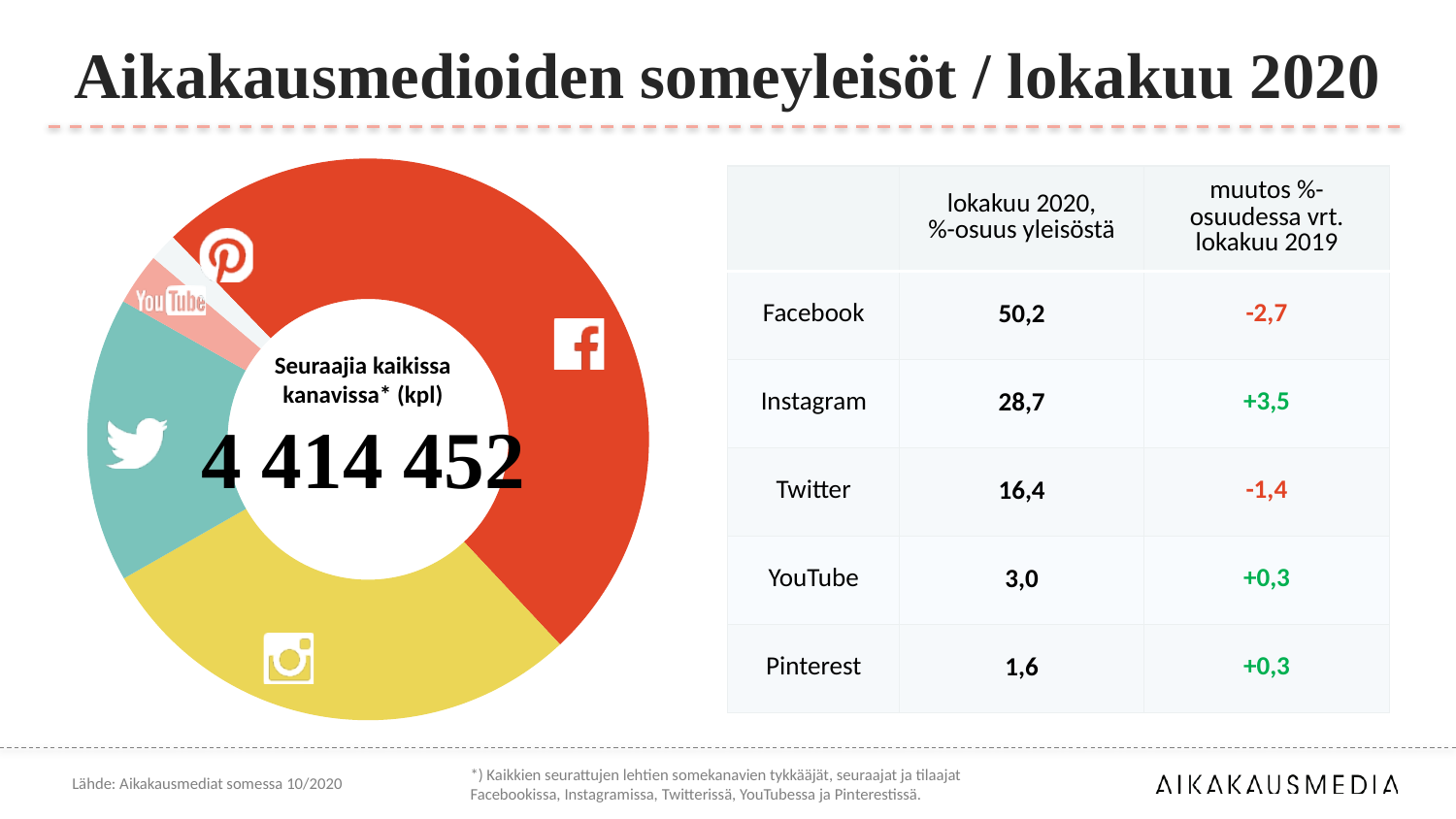
According to the table, what is Instagram's share of the audience in October 2020? 28,7 What is the change in Instagram's percentage share compared with October 2019? +3,5 Which channel shows the largest decrease in percentage share compared with October 2019? Facebook What total number of followers is printed in the centre of the donut chart? 4 414 452 What kind of chart is shown on the left of the slide? Donut (pie) chart Which slice is larger in the donut chart, Instagram or Twitter? Instagram What is the difference in percentage share between Facebook and Instagram in October 2020? 21,5 How many slices does the donut chart have? 5 According to the table, what is Twitter's share of the audience in October 2020? 16,4 According to the table, what is Facebook's share of the audience in October 2020? 50,2 Which channel has the smallest slice of the donut chart? Pinterest Which channel has the largest slice of the donut chart? Facebook